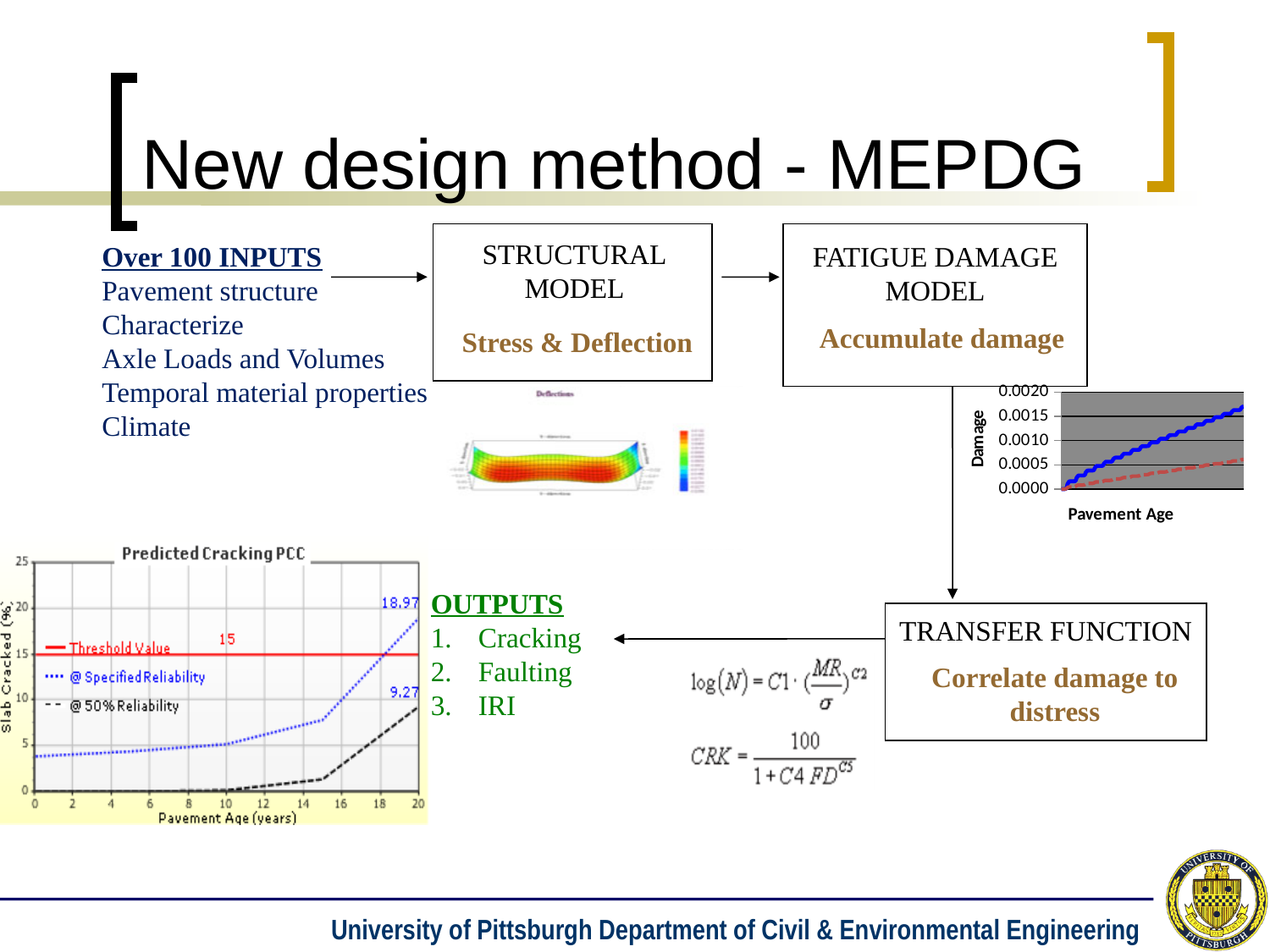
What is the label of the x axis of the Predicted Cracking PCC chart? Pavement Age (years) In the Predicted Cracking PCC chart, what is the difference between the @ Specified Reliability value and the @ 50% Reliability value at 20 years? 9.70 In the Predicted Cracking PCC chart, which is larger at 20 years: the @ Specified Reliability value or the @ 50% Reliability value? @ Specified Reliability In the Predicted Cracking PCC chart, is the @ Specified Reliability value at 20 years greater or less than the Threshold Value of 15? greater In the Predicted Cracking PCC chart, does the @ Specified Reliability line rise or fall as Pavement Age increases? rise In the Predicted Cracking PCC chart, what is the value of the @ 50% Reliability line at 20 years? 9.27 How many series does the legend of the Predicted Cracking PCC chart list? 3 What kind of chart is the Predicted Cracking PCC chart? line chart In the Damage vs Pavement Age chart on the right, is the final value of the red dashed line greater or less than 0.0010? less In the Predicted Cracking PCC chart, what is the value of the @ Specified Reliability line at 20 years? 18.97 In the Predicted Cracking PCC chart, what is the Threshold Value? 15 In the Damage vs Pavement Age chart on the right, is the final value of the blue solid line greater or less than 0.0015? greater